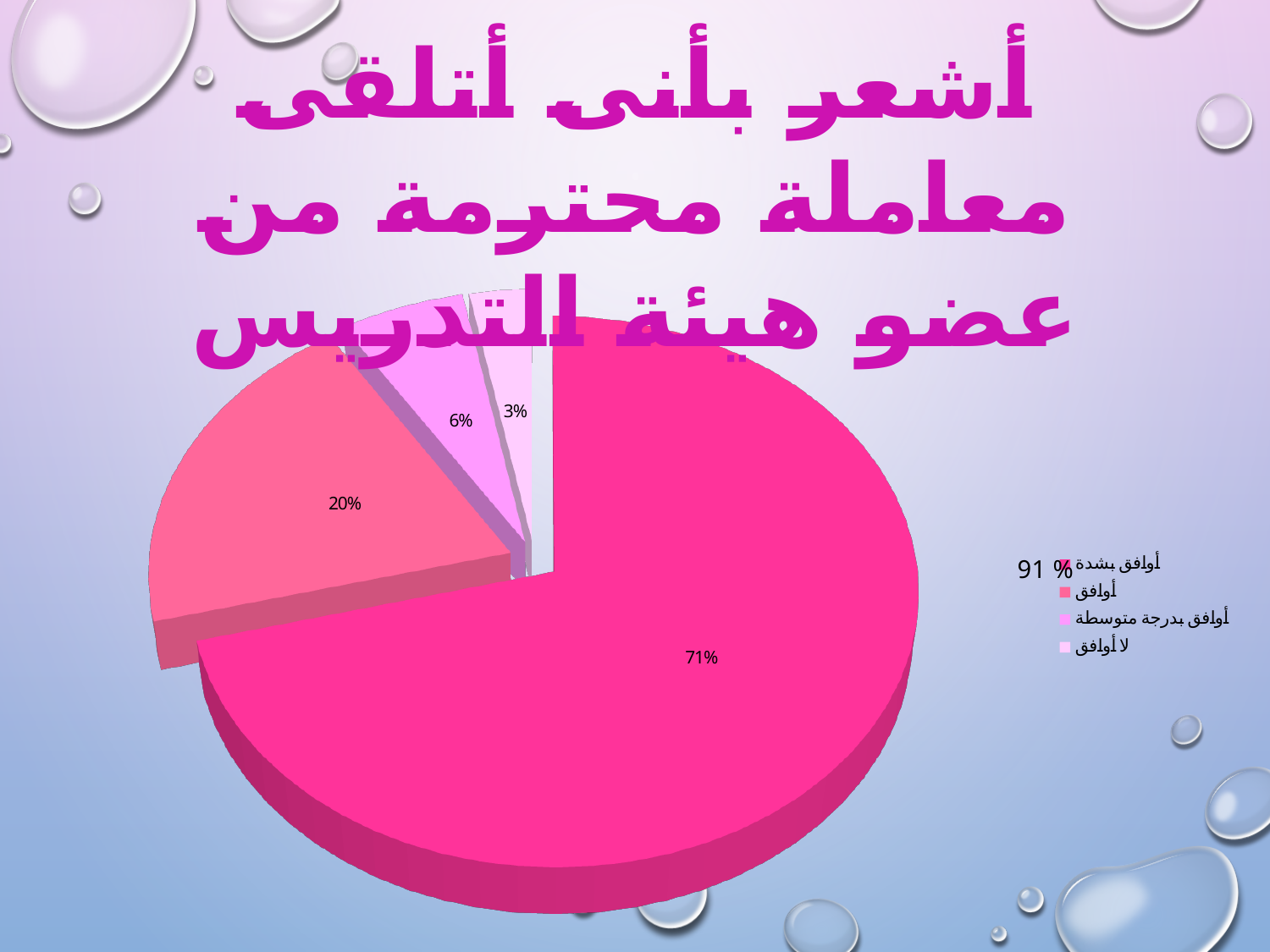
What percentage is shown for the 'لا أوافق' (disagree) slice? 3% Which legend category has the smallest share of the pie? لا أوافق What percentage is shown for the largest slice of the pie chart? 71% How many slices does the pie chart have? 4 What number is printed next to the legend of the pie chart? 91 % What is the difference in percentage points between the 71% slice and the 20% slice? 51 Which is larger, the 'أوافق' slice or the 'أوافق بدرجة متوسطة' slice? أوافق How many entries does the legend list? 4 What percentage is shown for the 'أوافق' (agree) slice? 20% What percentage is shown for the 'أوافق بدرجة متوسطة' (moderately agree) slice? 6% What kind of chart is shown on the slide? Pie chart Which legend category has the largest share of the pie? أوافق بشدة